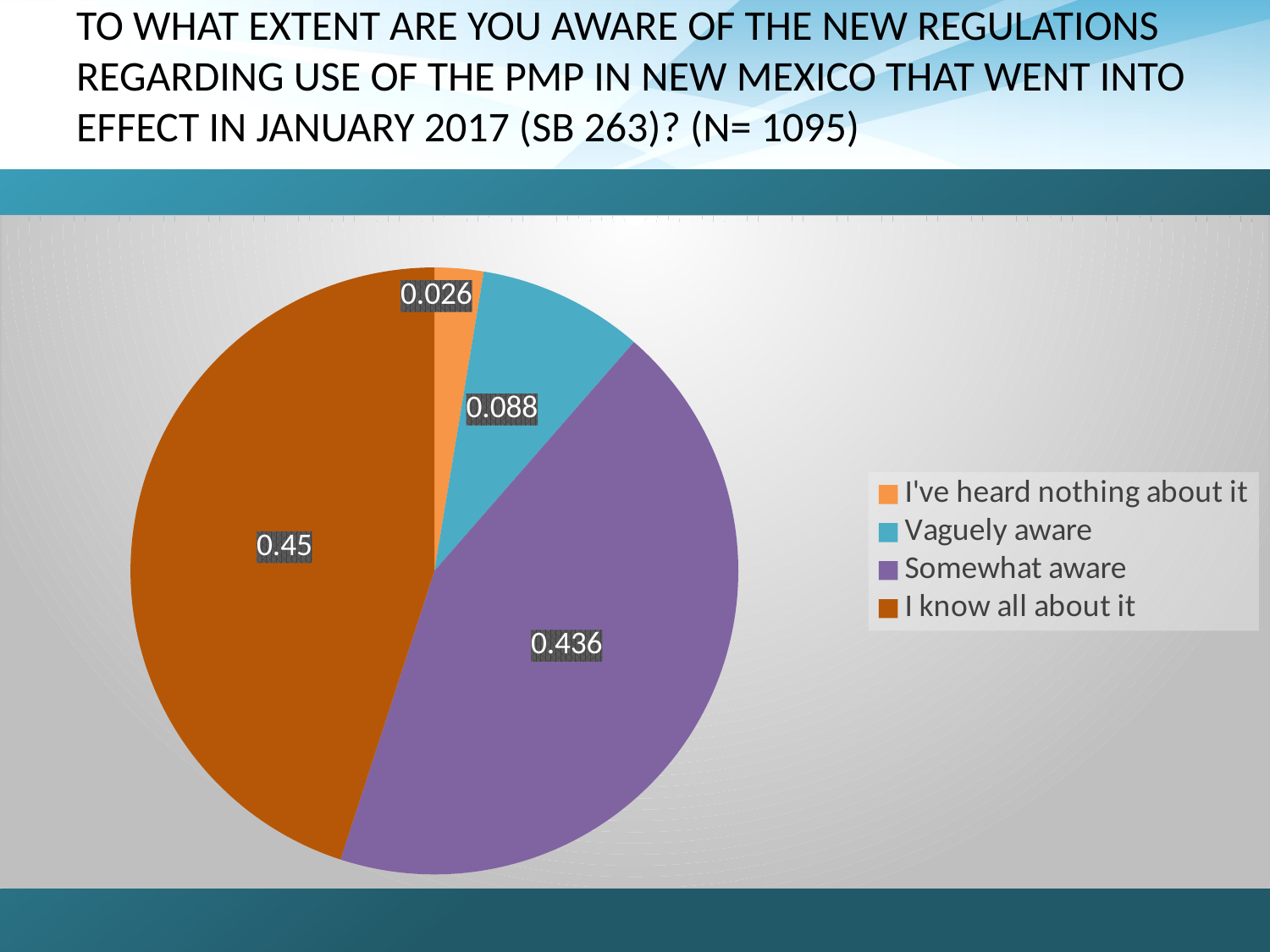
What is the value for "I've heard nothing about it"? 0.026 What is the value for "Somewhat aware"? 0.436 Which category has the largest slice of the pie? I know all about it What kind of chart is shown on the slide? pie chart What is the sample size (N) stated in the slide title? 1095 What is the difference between the values for "Vaguely aware" and "I've heard nothing about it"? 0.062 Which is larger, the value for "Vaguely aware" or the value for "I've heard nothing about it"? Vaguely aware What colour is the slice for "Somewhat aware"? purple What is the value for "I know all about it"? 0.45 How many categories does the pie chart have? 4 Which category has the smallest slice of the pie? I've heard nothing about it What is the value for "Vaguely aware"? 0.088